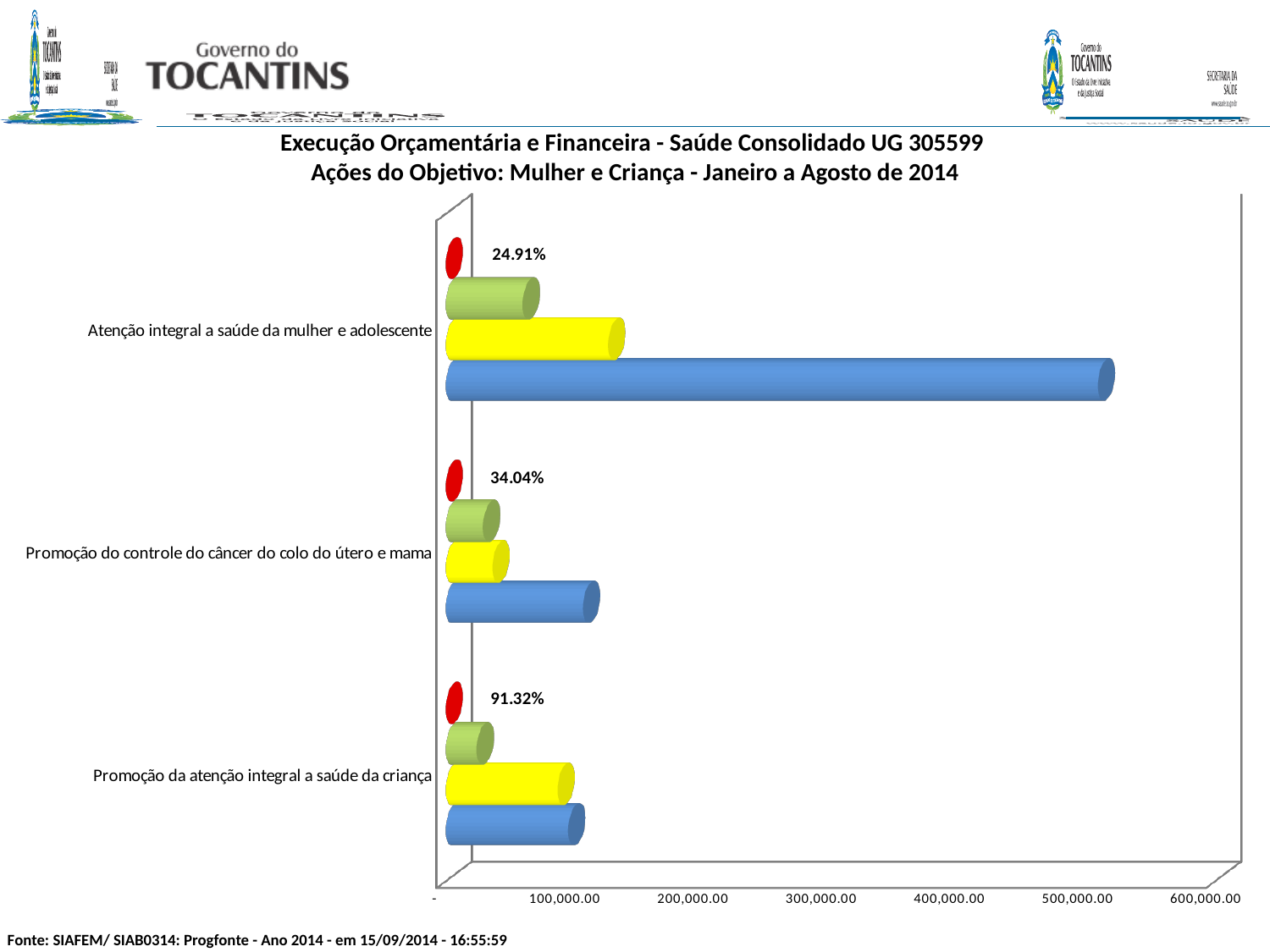
Which has the longer yellow bar: 'Atenção integral a saúde da mulher e adolescente' or 'Promoção do controle do câncer do colo do útero e mama'? Atenção integral a saúde da mulher e adolescente What percentage is shown for 'Atenção integral a saúde da mulher e adolescente'? 24.91% Which category has the lowest percentage label? Atenção integral a saúde da mulher e adolescente What kind of chart is shown on the slide? Bar chart Is the yellow bar for 'Promoção do controle do câncer do colo do útero e mama' greater or less than 100,000.00? less Which category has the longest blue bar? Atenção integral a saúde da mulher e adolescente What percentage is shown for 'Promoção do controle do câncer do colo do útero e mama'? 34.04% How many categories are shown on the chart? 3 What is the difference in percentage points between the labels for 'Promoção da atenção integral a saúde da criança' and 'Atenção integral a saúde da mulher e adolescente'? 66.41 Which category has the highest percentage label? Promoção da atenção integral a saúde da criança What percentage is shown for 'Promoção da atenção integral a saúde da criança'? 91.32% Is the blue bar for 'Atenção integral a saúde da mulher e adolescente' greater or less than 500,000.00? greater